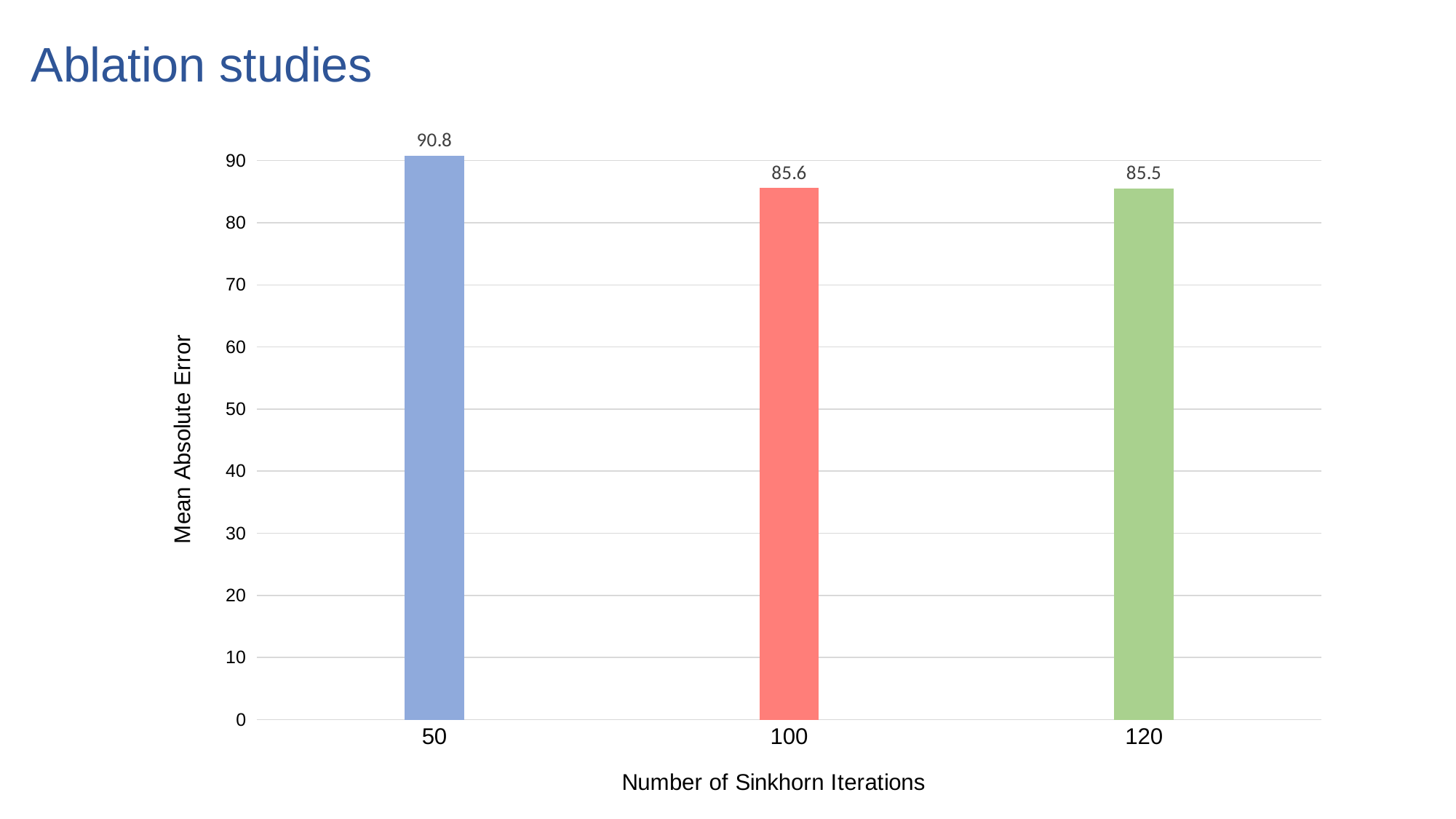
What is the difference in Mean Absolute Error between 50 and 100 Sinkhorn iterations? 5.2 What is the label of the y axis? Mean Absolute Error What is the Mean Absolute Error for 120 Sinkhorn iterations? 85.5 How many numbers of Sinkhorn iterations are shown on the x axis? 3 Which number of Sinkhorn iterations has the highest Mean Absolute Error? 50 What kind of chart is shown on the slide? bar chart Does the Mean Absolute Error rise or fall as the number of Sinkhorn iterations increases? fall Which has a larger Mean Absolute Error: 50 or 120 Sinkhorn iterations? 50 What is the Mean Absolute Error for 100 Sinkhorn iterations? 85.6 What is the Mean Absolute Error for 50 Sinkhorn iterations? 90.8 Is the Mean Absolute Error for 100 Sinkhorn iterations greater or less than 90? less What is the difference in Mean Absolute Error between 100 and 120 Sinkhorn iterations? 0.1